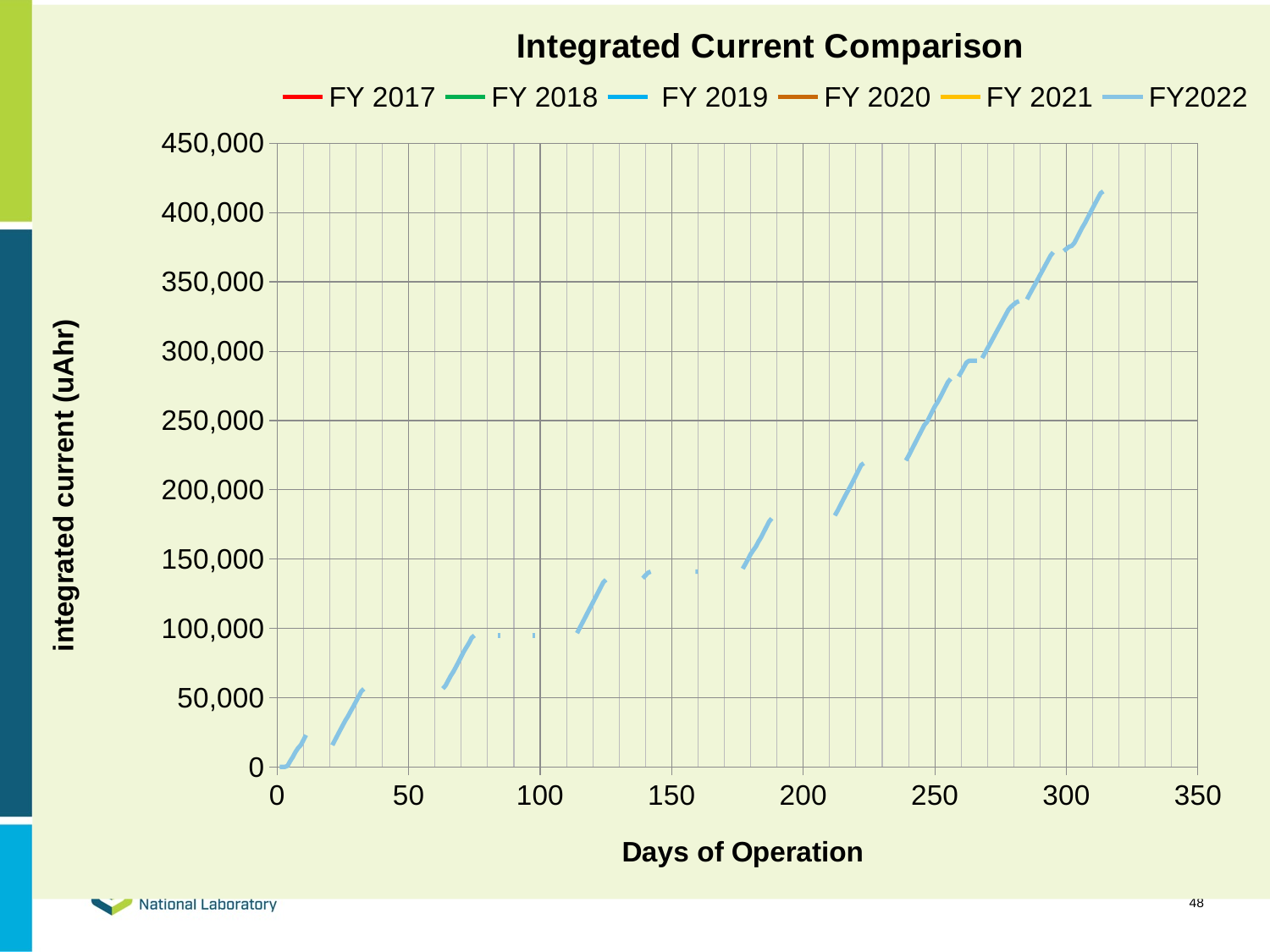
What is the maximum value shown on the y axis? 450,000 Is the highest FY2022 value plotted greater or less than 400,000? greater What is the title of the chart? Integrated Current Comparison Does the FY2022 line rise or fall as days of operation increase? rise What kind of chart is shown on the slide? line chart What is the label of the x axis? Days of Operation Is the FY2022 value at 300 days of operation greater or less than 350,000? greater Is the FY2022 value at 200 days of operation greater or less than 200,000? less How many series does the legend list? 6